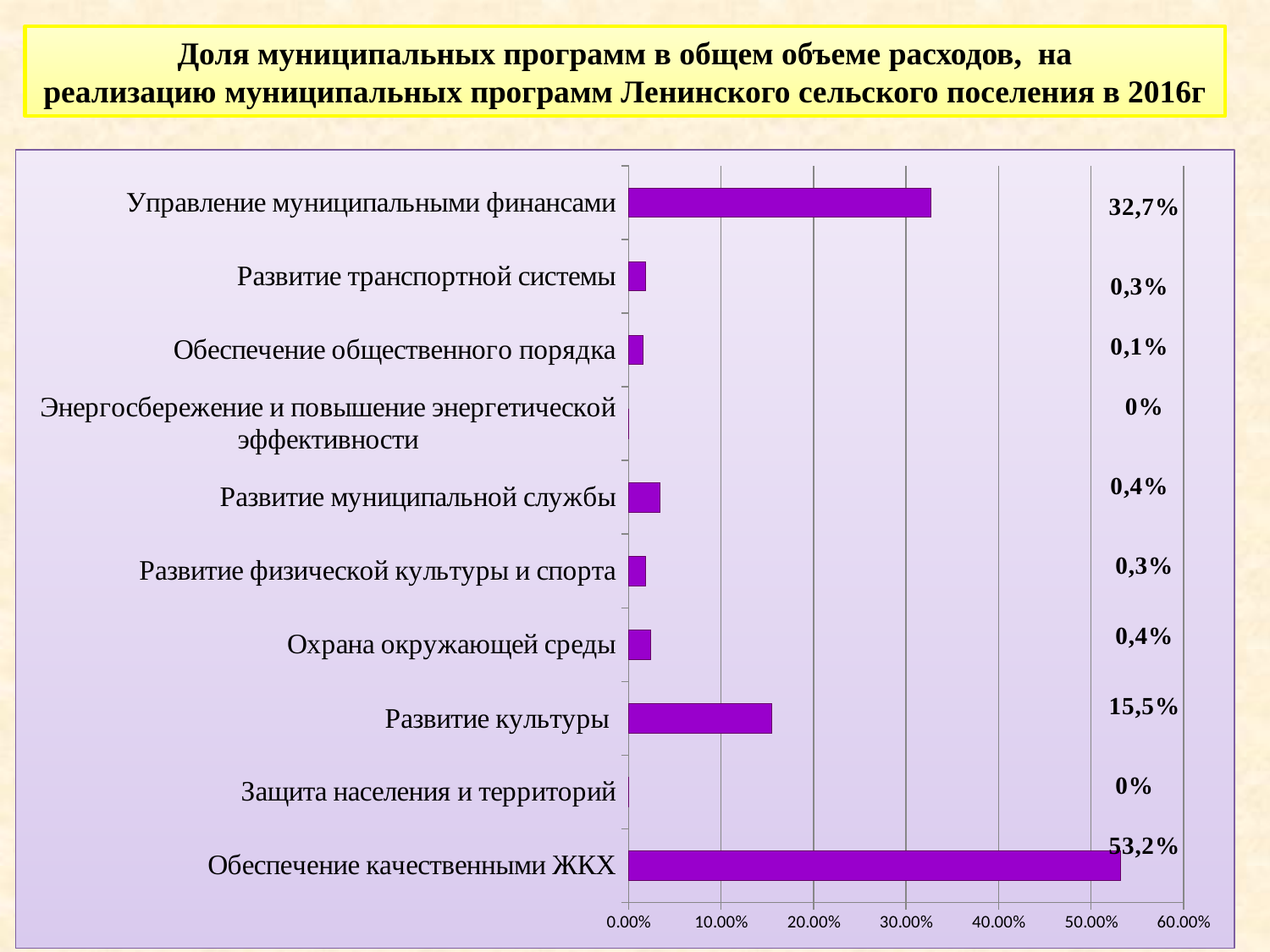
What is the value for Обеспечение качественными ЖКХ? 53,2% Which is larger: the value for Развитие культуры or the value for Управление муниципальными финансами? Управление муниципальными финансами Is the value for Развитие культуры greater or less than 20.00%? less What is the value for Развитие муниципальной службы? 0,4% Which category has the highest value? Обеспечение качественными ЖКХ What is the maximum value shown on the horizontal axis? 60.00% What is the difference between the values for Обеспечение качественными ЖКХ and Управление муниципальными финансами? 20,5% What kind of chart is shown on the slide? Bar chart How many categories (programs) are shown in the chart? 10 What is the value for Управление муниципальными финансами? 32,7% Is the value for Обеспечение качественными ЖКХ greater or less than 50.00%? greater What is the value for Развитие культуры? 15,5%